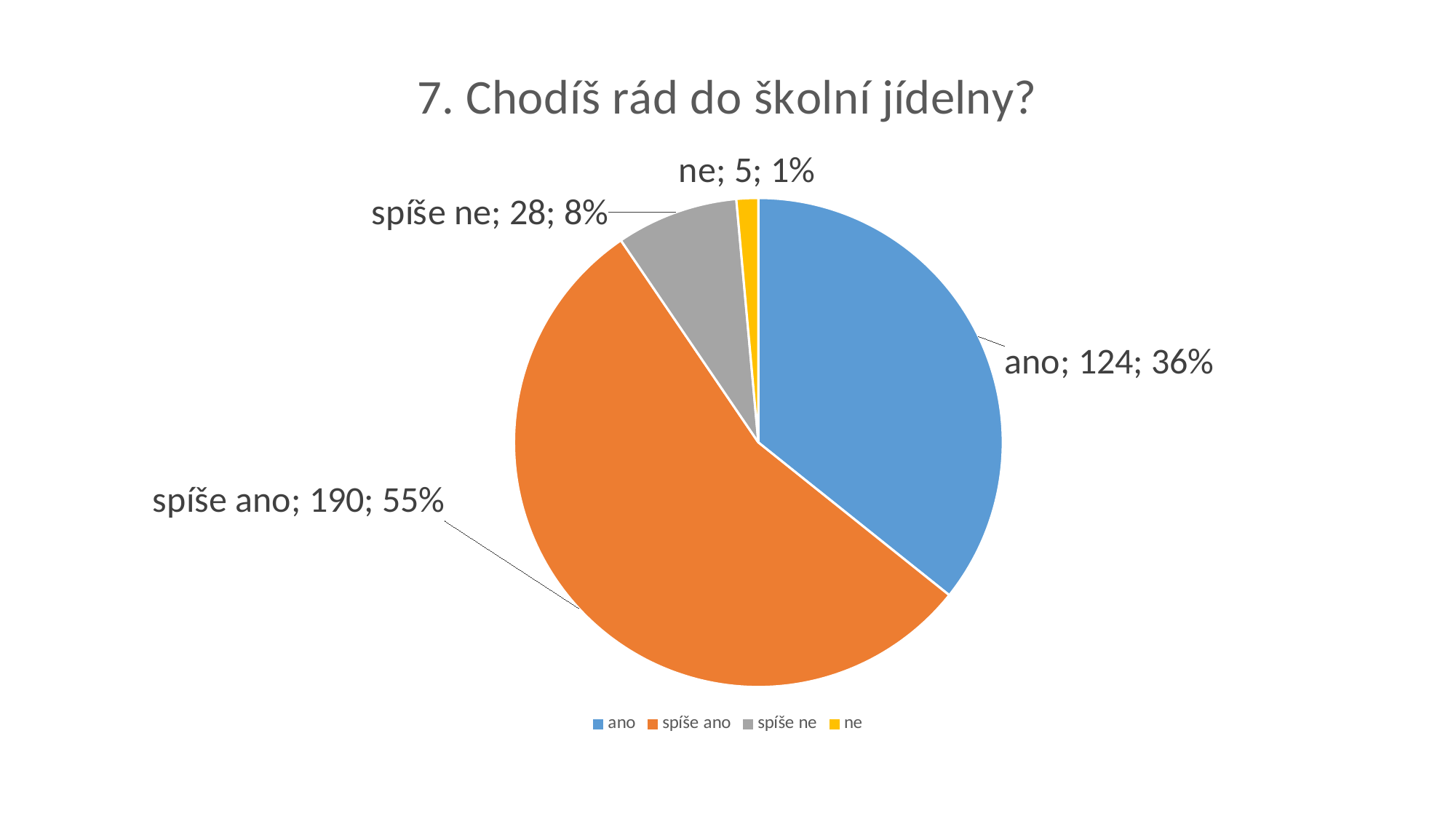
What kind of chart is shown on the slide? pie chart Which category has the largest slice? spíše ano What is the count for "ano"? 124 What is the count for "spíše ne"? 28 What is the title of the chart? 7. Chodíš rád do školní jídelny? Which category has the smallest slice? ne What is the count for "ne"? 5 How many slices does the pie chart have? 4 What share of the pie does "spíše ano" represent? 55% What is the count for "spíše ano"? 190 What is the difference between the counts for "spíše ano" and "ano"? 66 How many entries does the legend list? 4